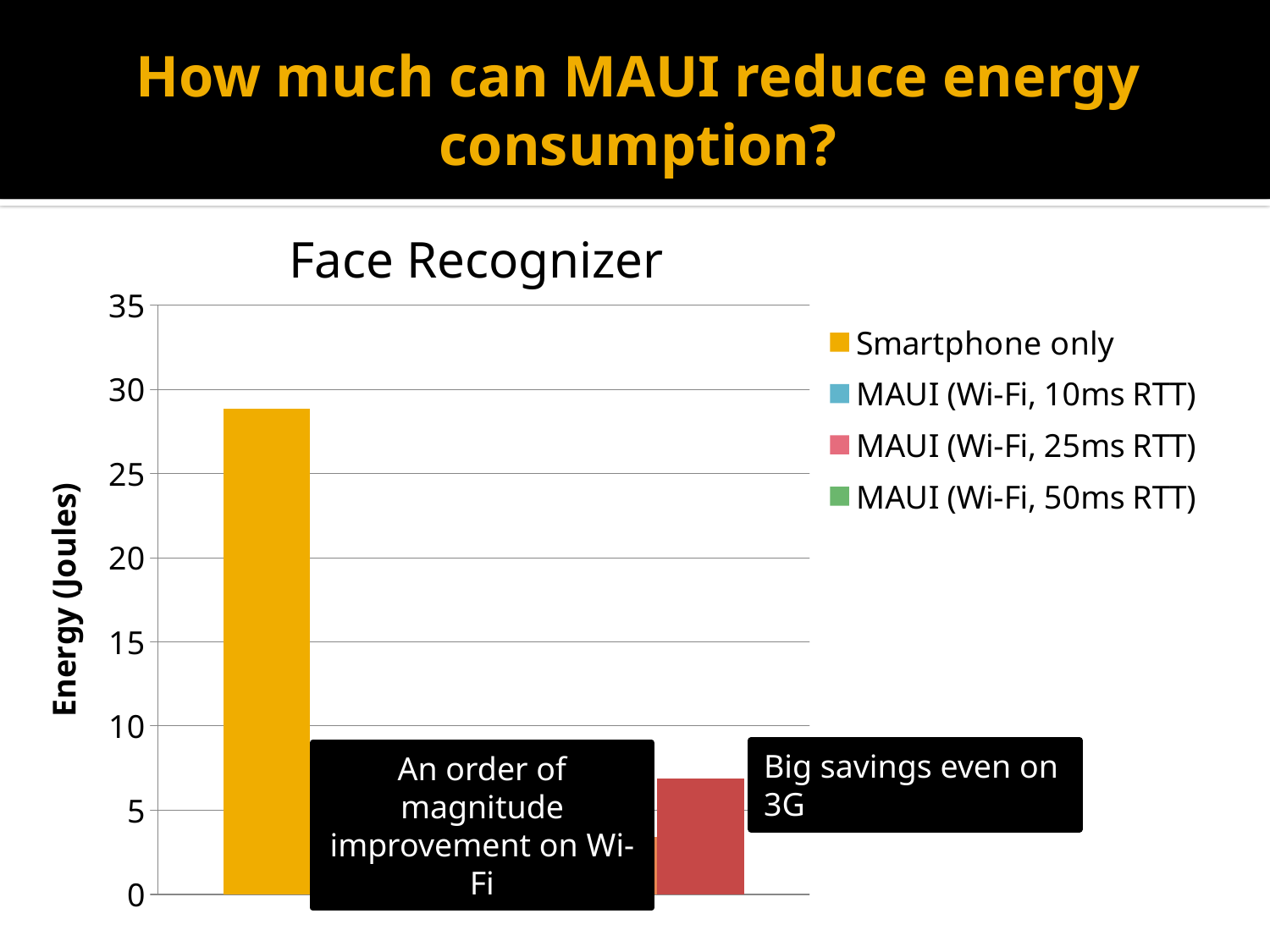
What is the label of the vertical axis? Energy (Joules) How many series does the chart's legend list? 4 What is the title of the chart? Face Recognizer Is the value for Smartphone only greater or less than 30? less Which is larger, the value for Smartphone only or the value for MAUI (Wi-Fi, 25ms RTT)? Smartphone only What kind of chart is shown on the slide? bar chart Is the value for Smartphone only greater or less than 25? greater What is the highest value shown on the vertical axis? 35 Which series has the highest bar in the chart? Smartphone only Is the value for MAUI (Wi-Fi, 25ms RTT) greater or less than 10? less